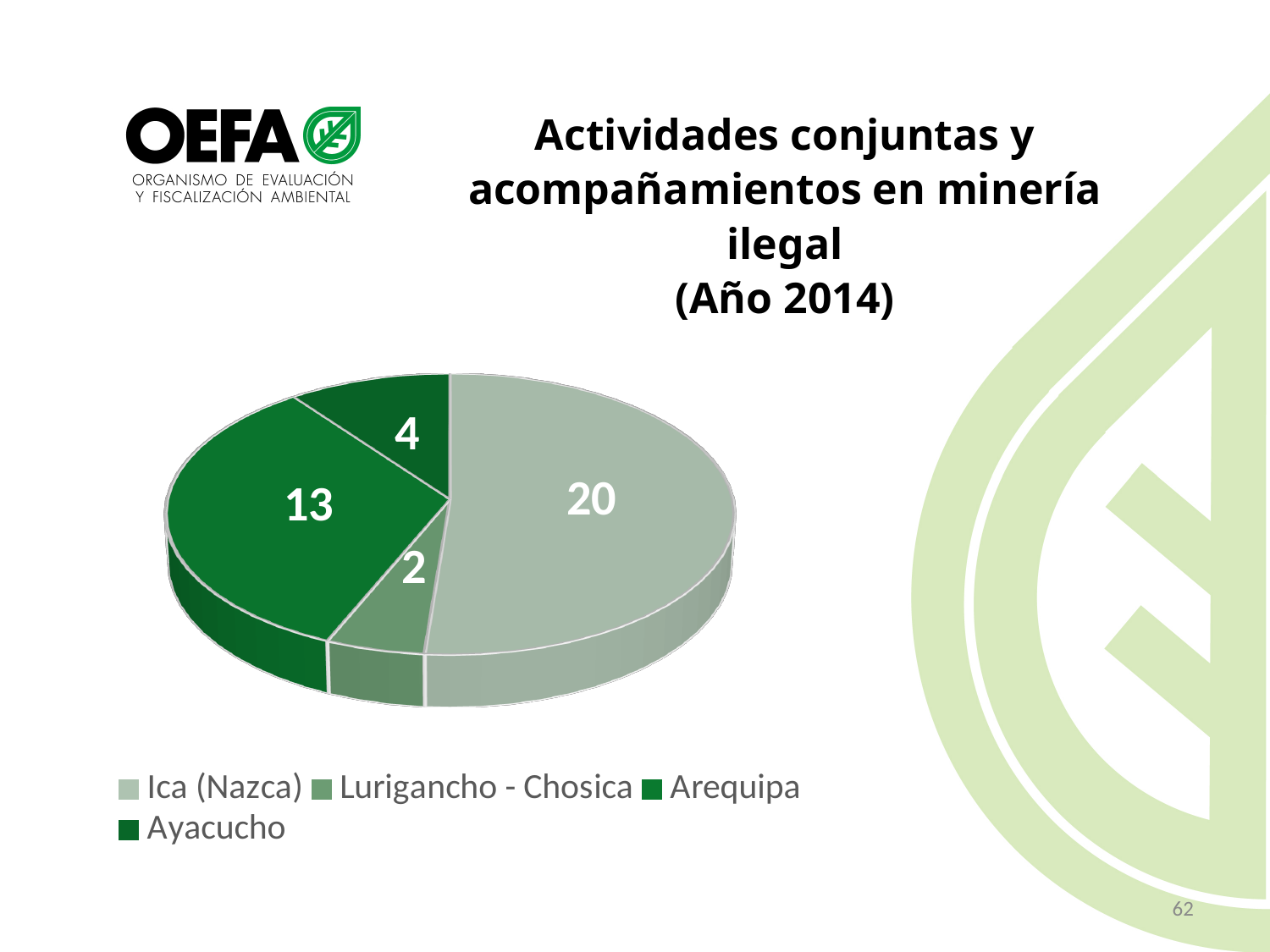
Which category has the smallest slice of the pie? Lurigancho - Chosica What is the value for Lurigancho - Chosica? 2 Which category has the largest slice of the pie? Ica (Nazca) What is the total of all the slices in the pie chart? 39 What type of chart is shown on the slide? Pie chart What is the value for Arequipa? 13 What is the value for Ica (Nazca)? 20 What is the difference between the values for Ica (Nazca) and Arequipa? 7 Which is larger, the value for Ayacucho or the value for Lurigancho - Chosica? Ayacucho What year does the chart title refer to? 2014 What is the value for Ayacucho? 4 How many categories does the pie chart show? 4